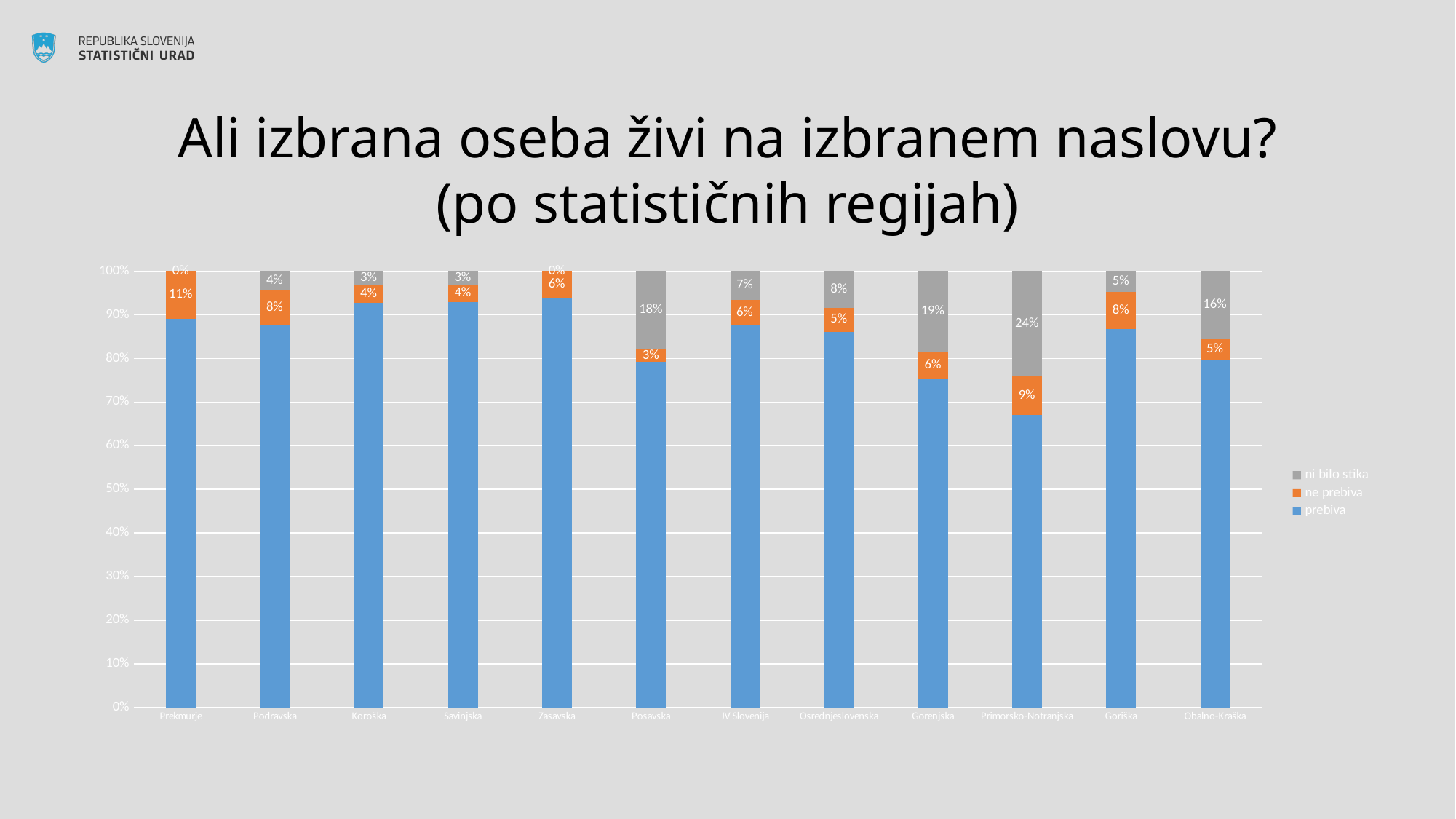
Is the 'prebiva' value for Primorsko-Notranjska greater or less than 70%? less How many series does the legend list? 3 What kind of chart is shown on the slide? Stacked bar chart What is the 'ne prebiva' value for Prekmurje? 11% Which is larger, the 'ne prebiva' value for Podravska or for Osrednjeslovenska? Podravska How many regions are shown on the x axis? 12 What is the difference between the 'ni bilo stika' values for Posavska and Obalno-Kraška? 2% Which region has the highest 'ni bilo stika' value? Primorsko-Notranjska Is the 'prebiva' value for Prekmurje greater or less than 80%? greater What is the 'ne prebiva' value for Primorsko-Notranjska? 9% Which region has the lowest 'ne prebiva' value? Posavska What is the 'ni bilo stika' value for Gorenjska? 19%